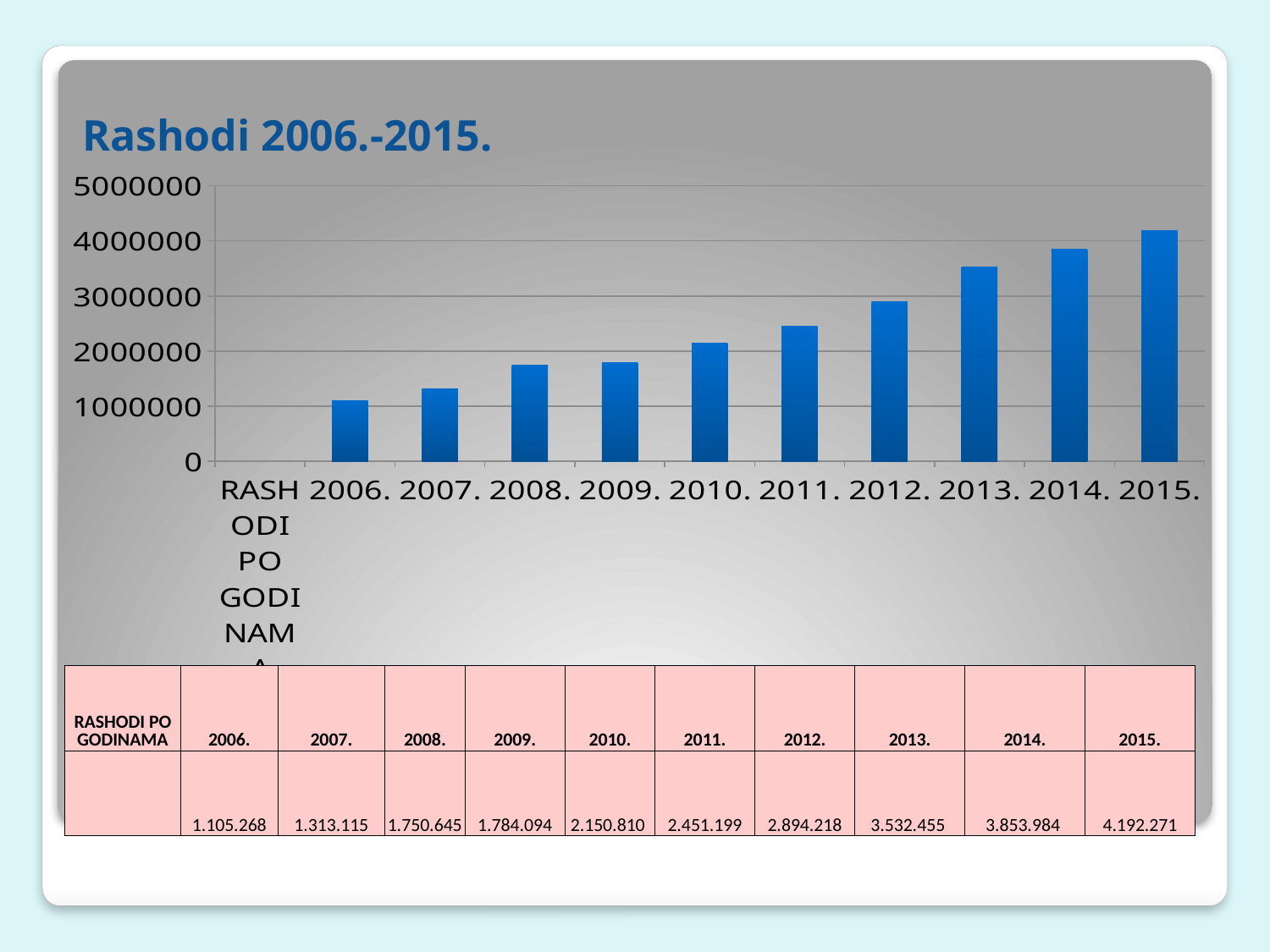
Do the values rise or fall from 2006. to 2015.? rise What type of chart is shown on the slide? bar chart What is the value for 2006.? 1.105.268 Is the value for 2009. greater or less than 2000000? less What is the difference between the values for 2014. and 2013.? 321.529 What is the value for 2015.? 4.192.271 Which year has the lowest value? 2006. What is the difference between the values for 2015. and 2006.? 3.087.003 Which year has the highest value? 2015. What is the value for 2010.? 2.150.810 Which is larger, the value for 2011. or the value for 2012.? 2012. What is the title of the chart? Rashodi 2006.-2015.